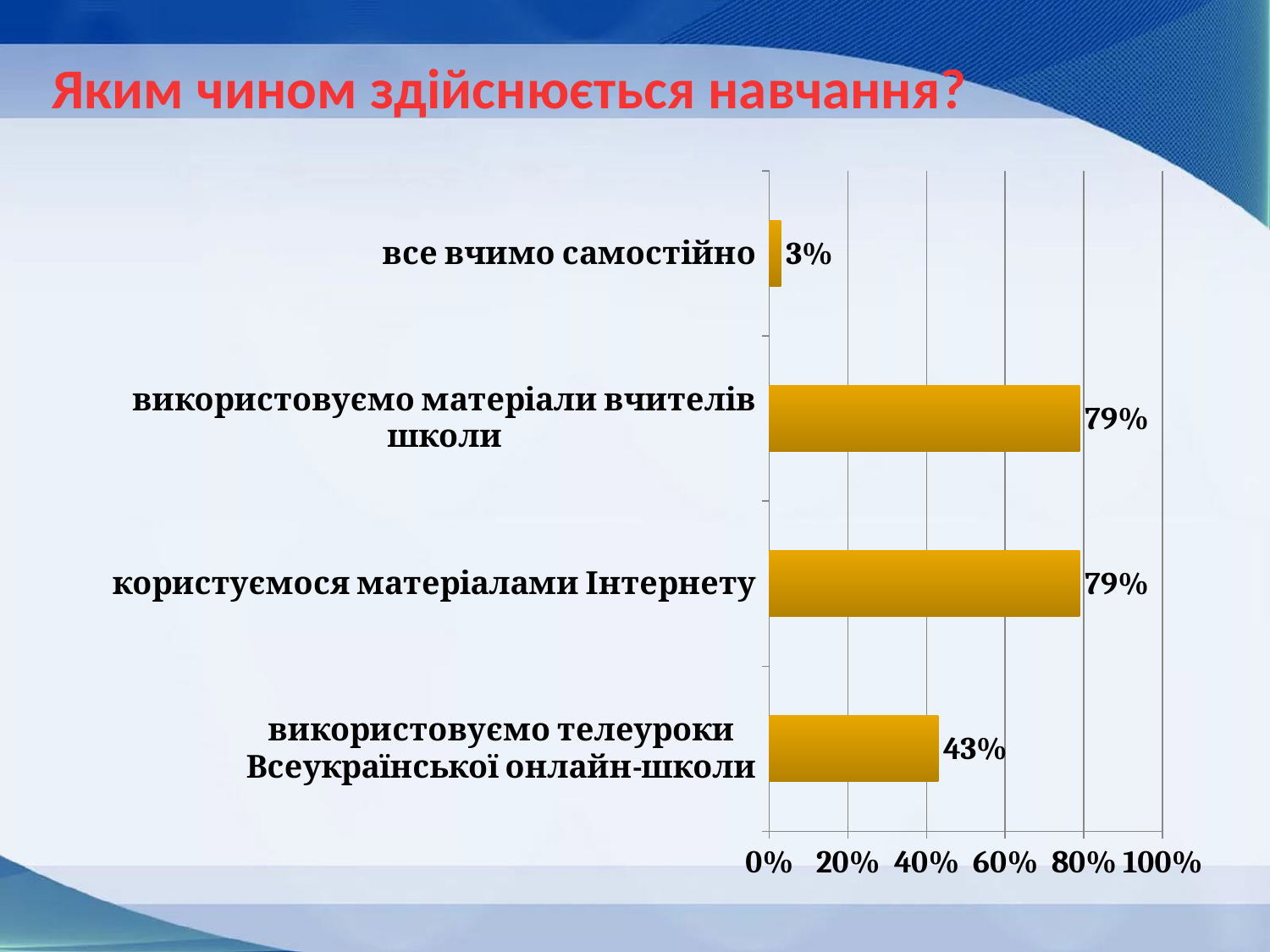
What is the difference between the values for "користуємося матеріалами Інтернету" and "використовуємо телеуроки Всеукраїнської онлайн-школи"? 36% What kind of chart is shown on the slide? bar chart How many categories are shown in the chart? 4 What value is shown for "все вчимо самостійно"? 3% Which is larger: the value for "використовуємо телеуроки Всеукраїнської онлайн-школи" or the value for "все вчимо самостійно"? використовуємо телеуроки Всеукраїнської онлайн-школи Which category has the lowest value? все вчимо самостійно What value is shown for "використовуємо матеріали вчителів школи"? 79% Is the value for "використовуємо матеріали вчителів школи" greater or less than 60%? greater What value is shown for "використовуємо телеуроки Всеукраїнської онлайн-школи"? 43% What is the difference between the values for "використовуємо телеуроки Всеукраїнської онлайн-школи" and "все вчимо самостійно"? 40% What is the title of the slide? Яким чином здійснюється навчання? What value is shown for "користуємося матеріалами Інтернету"? 79%